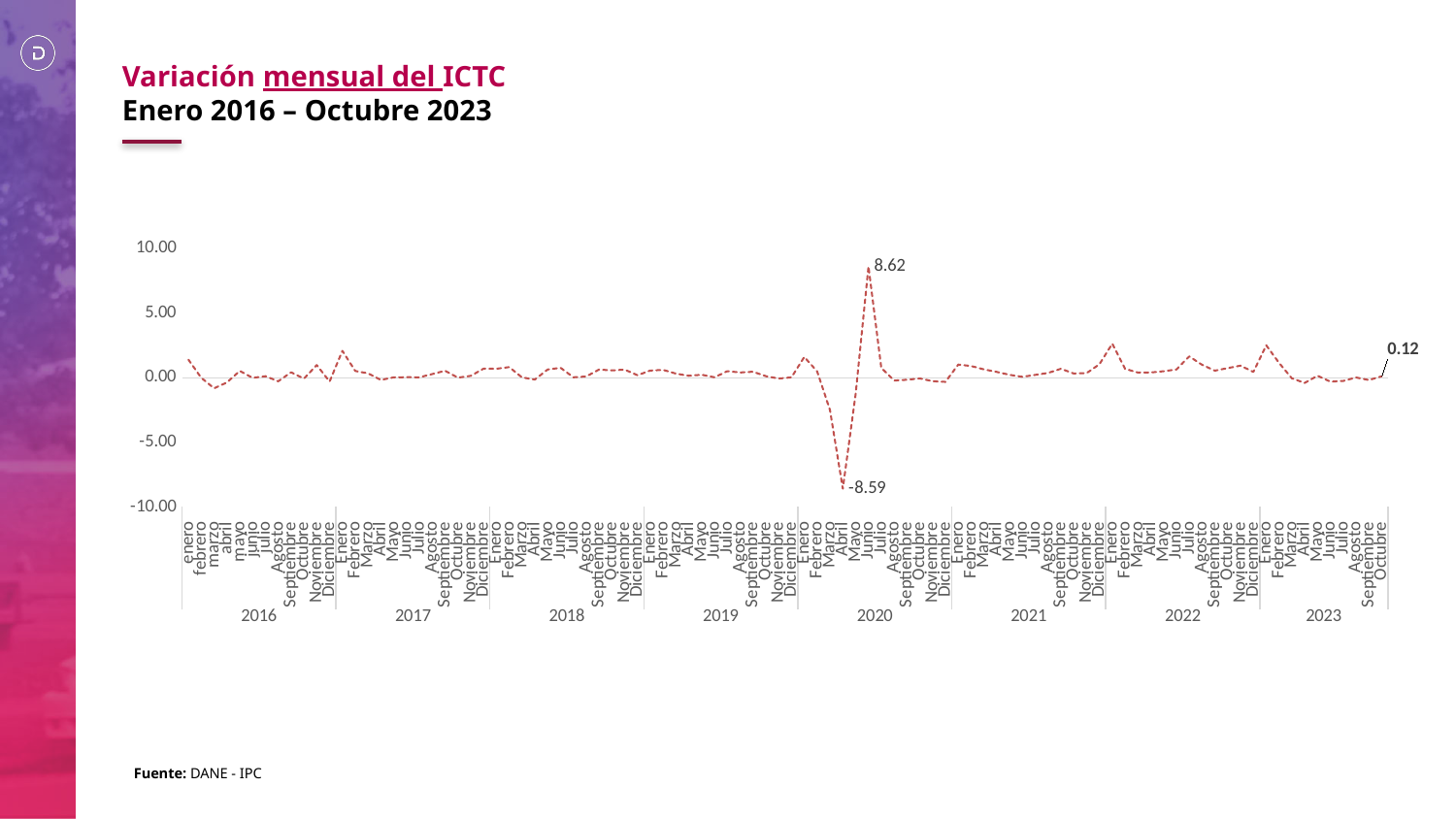
What kind of chart is shown on the slide? Line chart Is the peak value in 2020 greater or less than 5.00? greater What is the lowest value labelled on the chart? -8.59 What is the title of the chart on the slide? Variación mensual del ICTC Enero 2016 – Octubre 2023 In which year does the chart's highest labelled value (8.62) occur? 2020 Is the lowest value in 2020 greater or less than -5.00? less What is the difference between the peak value of 8.62 and the final value of 0.12? 8.50 How many years are labelled along the x axis of the chart? 8 What is the value labelled for the last point on the chart (Octubre 2023)? 0.12 In which year does the chart's lowest labelled value (-8.59) occur? 2020 What is the highest value labelled on the chart? 8.62 What is the difference between the highest labelled value (8.62) and the lowest labelled value (-8.59)? 17.21